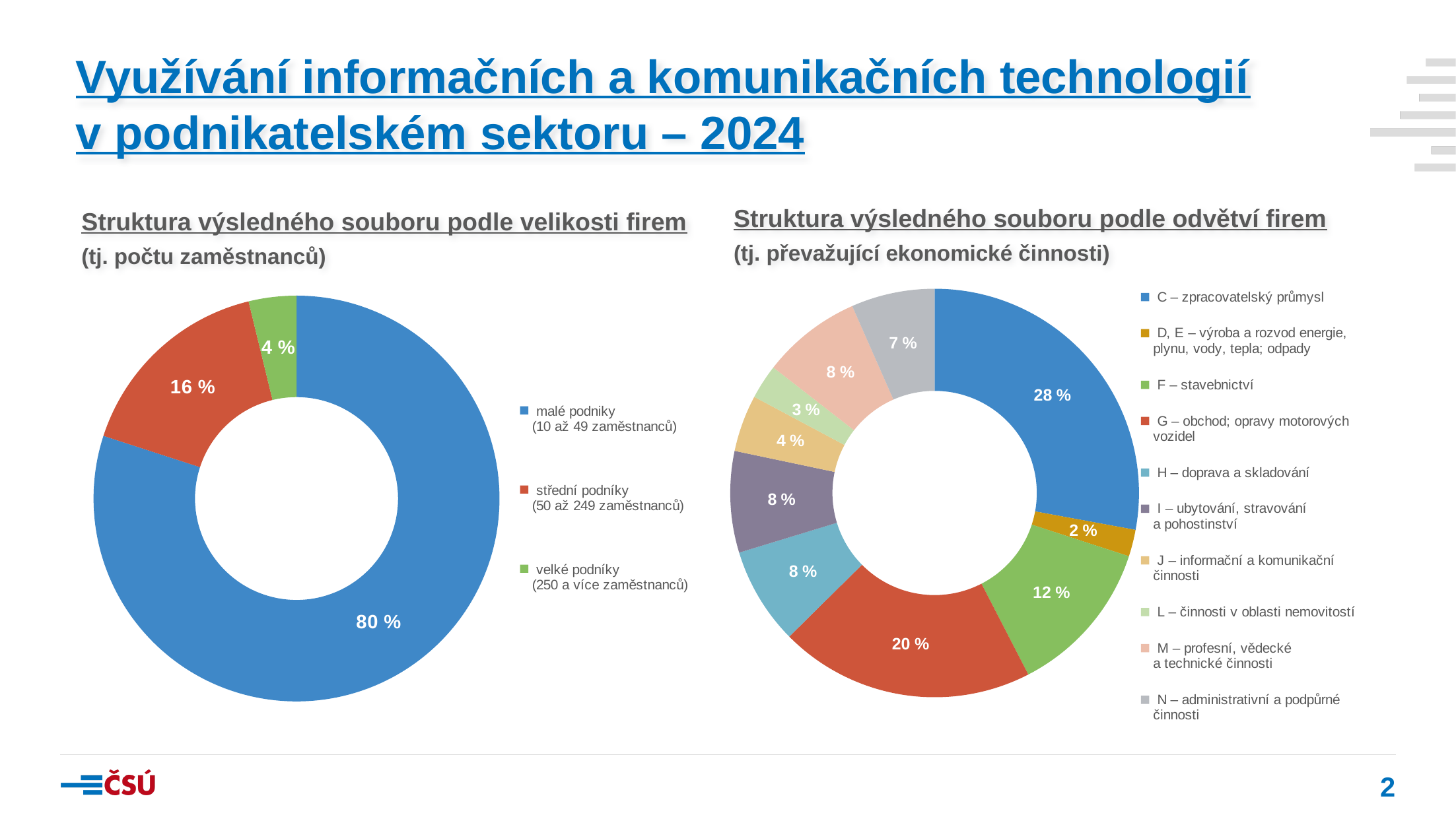
In the left chart (Struktura výsledného souboru podle velikosti firem), what is the difference between the shares of malé podniky and střední podniky? 64 % How many entries does the legend of the right chart (Struktura výsledného souboru podle odvětví firem) list? 10 In the right chart (Struktura výsledného souboru podle odvětví firem), what share does C – zpracovatelský průmysl have? 28 % What kind of chart is the right chart (Struktura výsledného souboru podle odvětví firem)? Pie (doughnut) chart In the right chart (Struktura výsledného souboru podle odvětví firem), which is larger: the share of F – stavebnictví or the share of N – administrativní a podpůrné činnosti? F – stavebnictví In the right chart (Struktura výsledného souboru podle odvětví firem), which sector has the smallest share? D, E – výroba a rozvod energie, plynu, vody, tepla; odpady In the left chart (Struktura výsledného souboru podle velikosti firem), what share do malé podniky (10 až 49 zaměstnanců) have? 80 % In the left chart (Struktura výsledného souboru podle velikosti firem), what share do střední podniky (50 až 249 zaměstnanců) have? 16 % In the right chart (Struktura výsledného souboru podle odvětví firem), what is the difference between the shares of C – zpracovatelský průmysl and F – stavebnictví? 16 % In the left chart (Struktura výsledného souboru podle velikosti firem), which category has the smallest share? velké podniky (250 a více zaměstnanců) In the right chart (Struktura výsledného souboru podle odvětví firem), what share does G – obchod; opravy motorových vozidel have? 20 % In the left chart (Struktura výsledného souboru podle velikosti firem), how many categories are shown? 3